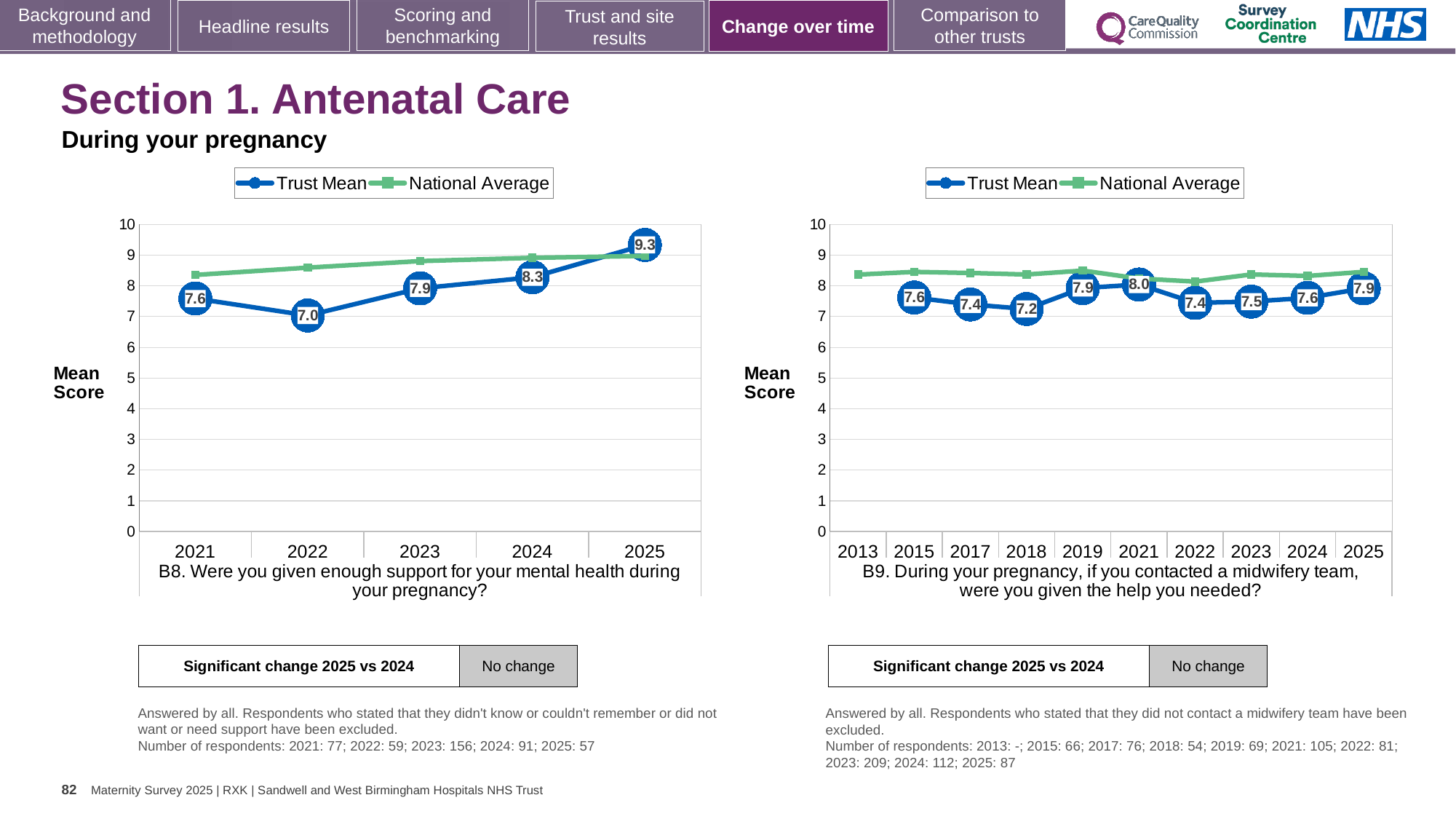
In the left chart (B8), is the National Average for 2021 greater or less than 8? greater What type of chart is the left chart (B8)? Line chart In the left chart (B8), what is the Trust Mean for 2025? 9.3 In the left chart (B8), which year has the lowest Trust Mean? 2022 In the right chart (B9), what is the Trust Mean for 2018? 7.2 In the right chart (B9), which year has the lowest Trust Mean? 2018 How many years are shown on the x axis of the right chart (B9)? 10 In the left chart (B8), what is the difference between the Trust Mean in 2025 and in 2021? 1.7 In the left chart (B8), which year has the highest Trust Mean? 2025 In the right chart (B9), is the Trust Mean higher in 2019 or in 2022? 2019 In the right chart (B9), what is the Trust Mean for 2021? 8.0 In the left chart (B8), what is the Trust Mean for 2022? 7.0